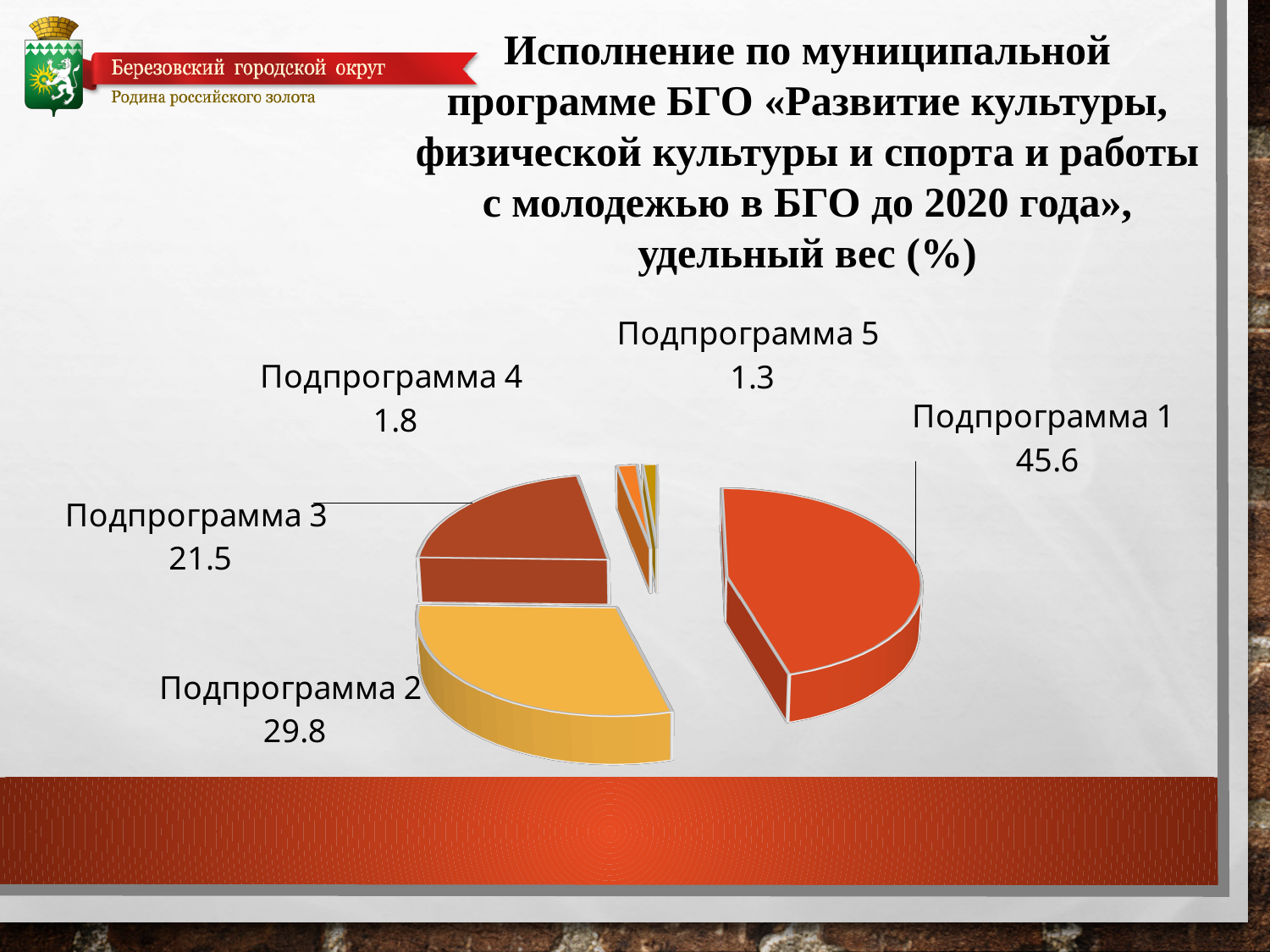
Which is larger, the value for Подпрограмма 2 or Подпрограмма 3? Подпрограмма 2 What value is shown for Подпрограмма 3? 21.5 What unit does the chart title say the values are expressed in? удельный вес (%) Which subprogram has the smallest share of the pie? Подпрограмма 5 What value is shown for Подпрограмма 5? 1.3 What value is shown for Подпрограмма 1? 45.6 What value is shown for Подпрограмма 2? 29.8 What is the difference between the values for Подпрограмма 1 and Подпрограмма 2? 15.8 What is the difference between the values for Подпрограмма 4 and Подпрограмма 5? 0.5 What kind of chart is shown on the slide? Pie chart Which subprogram has the largest share of the pie? Подпрограмма 1 How many slices does the pie chart have? 5